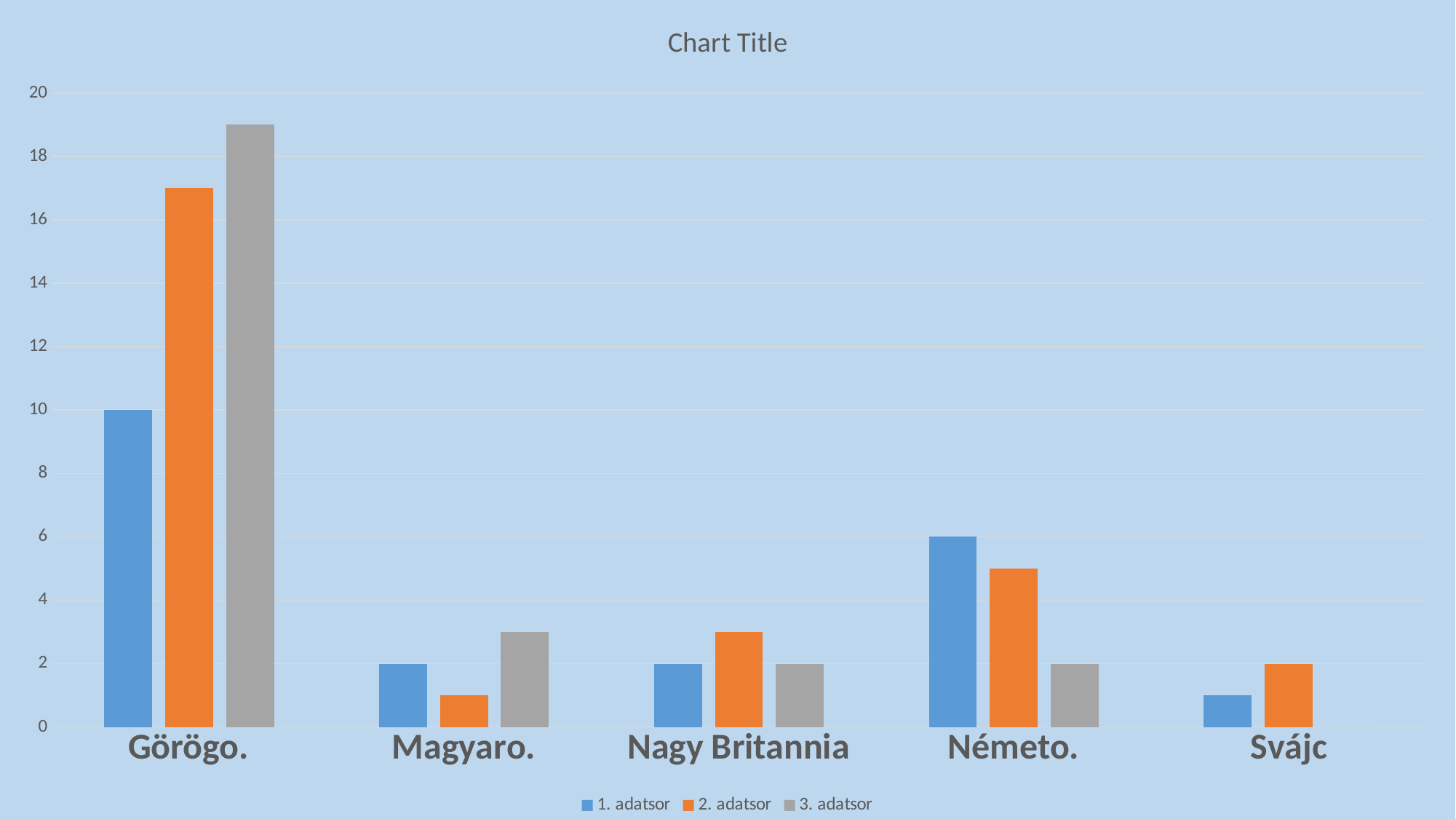
What kind of chart is shown on the slide? bar chart Is the value of 2. adatsor for Németo. greater or less than 4? greater Which is larger for Magyaro.: 1. adatsor or 2. adatsor? 1. adatsor Which category has the lowest value for 1. adatsor? Svájc What is the value of 3. adatsor for Nagy Britannia? 2 What is the difference between the 1. adatsor values for Görögo. and Németo.? 4 How many series does the legend list? 3 Is the value of 3. adatsor for Görögo. greater or less than 18? greater Which category has the highest value for 3. adatsor? Görögo. What is the value of 1. adatsor for Görögo.? 10 How many categories are shown on the x axis? 5 What is the value of 1. adatsor for Németo.? 6